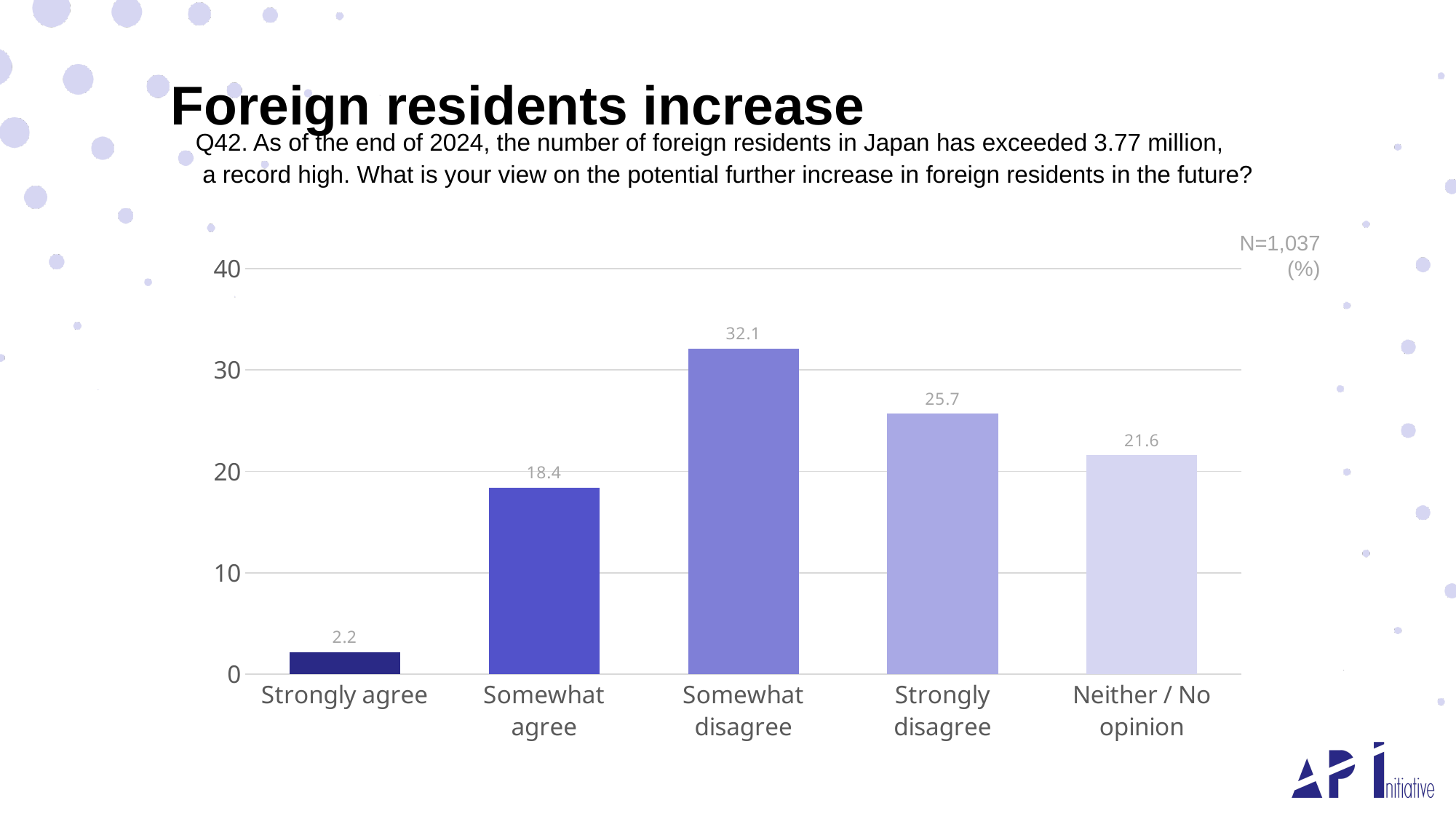
Which category has the highest value? Somewhat disagree Is the value for Somewhat agree greater or less than 20? less What is the value for Strongly agree? 2.2 What is the value for Neither / No opinion? 21.6 Which category has the lowest value? Strongly agree Which is larger, Strongly disagree or Neither / No opinion? Strongly disagree How many categories are shown on the chart? 5 What is the value for Somewhat disagree? 32.1 What kind of chart is shown on the slide? bar chart What is the sample size (N) shown on the chart? N=1,037 What is the difference between Somewhat disagree and Strongly disagree? 6.4 What is the difference between Somewhat agree and Strongly agree? 16.2